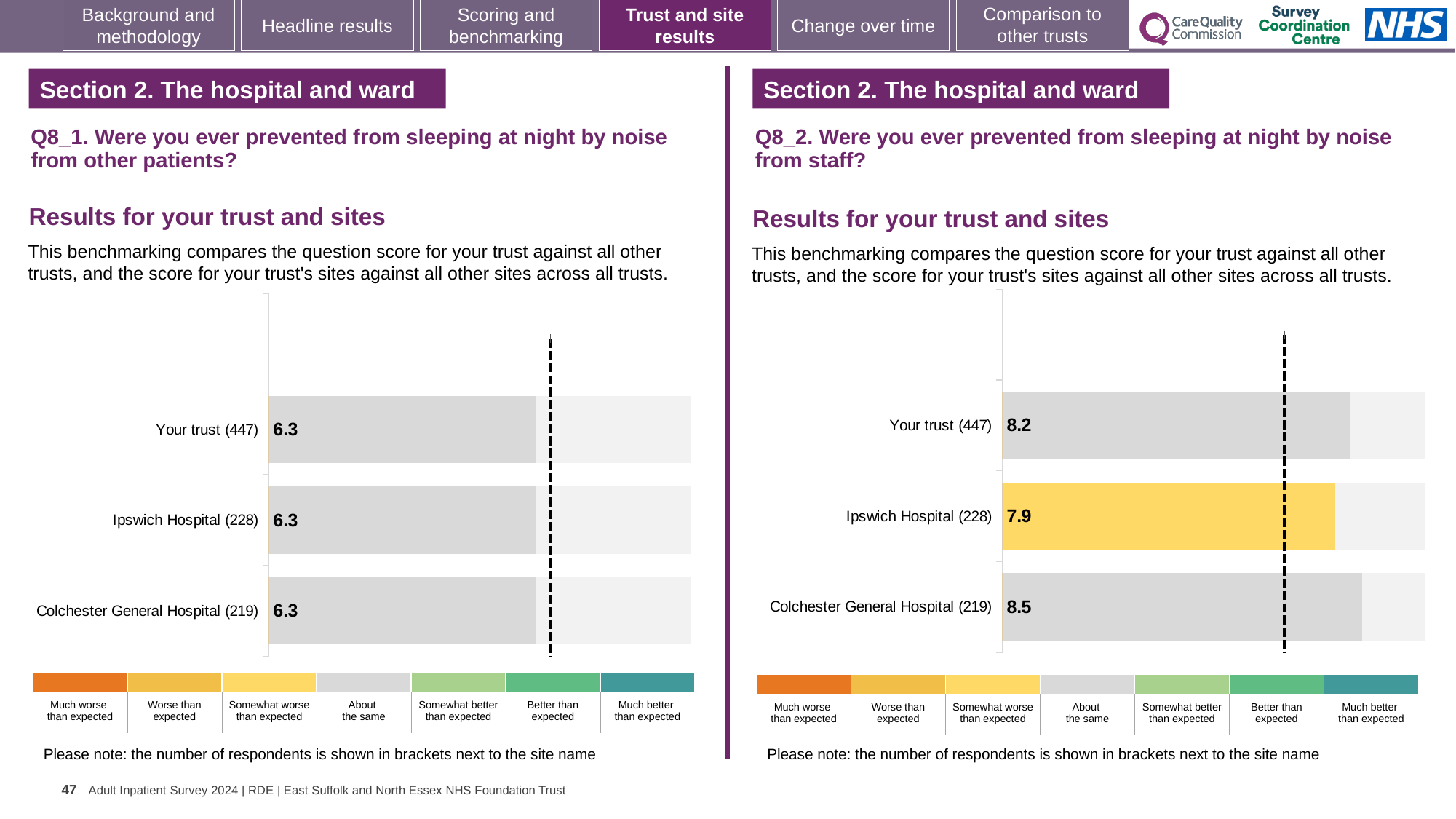
On the Q8_2 chart (noise from staff), what benchmark category does the yellow colour of the Ipswich Hospital bar represent according to the legend? Somewhat worse than expected On the Q8_2 chart (noise from staff), what is the score for Ipswich Hospital (228)? 7.9 On the Q8_2 chart (noise from staff), what is the difference between the scores for Colchester General Hospital (219) and Ipswich Hospital (228)? 0.6 On the Q8_2 chart (noise from staff), which site or trust has the lowest score? Ipswich Hospital (228) How many bars are plotted on the Q8_1 chart (noise from other patients)? 3 On the Q8_2 chart (noise from staff), which bar is coloured yellow rather than grey? Ipswich Hospital (228) On the Q8_2 chart (noise from staff), which has the larger score, Your trust (447) or Ipswich Hospital (228)? Your trust (447) On the Q8_1 chart (noise from other patients), what is the score for Colchester General Hospital (219)? 6.3 What type of chart is used on the Q8_2 chart (noise from staff)? Bar chart On the Q8_2 chart (noise from staff), what is the score for Your trust (447)? 8.2 On the Q8_1 chart (noise from other patients), what is the score for Your trust (447)? 6.3 On the Q8_2 chart (noise from staff), which site or trust has the highest score? Colchester General Hospital (219)